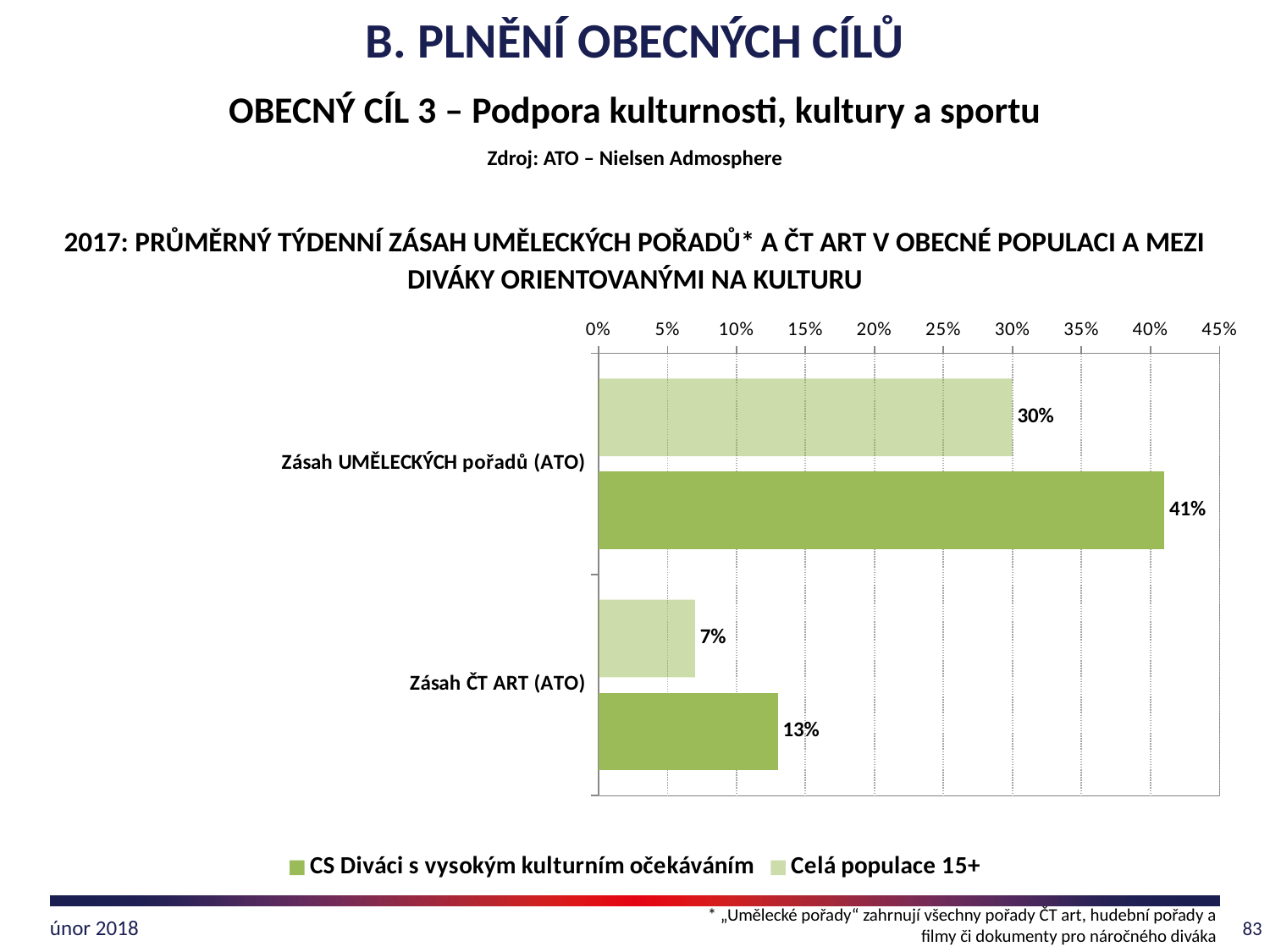
Which bar has the lowest value on the chart? Celá populace 15+, Zásah ČT ART (ATO) What is the value for 'CS Diváci s vysokým kulturním očekáváním' in the 'Zásah UMĚLECKÝCH pořadů (ATO)' category? 41% Which series has the larger value in the 'Zásah ČT ART (ATO)' category? CS Diváci s vysokým kulturním očekáváním What kind of chart is shown on the slide? Bar chart Which bar has the highest value on the chart? CS Diváci s vysokým kulturním očekáváním, Zásah UMĚLECKÝCH pořadů (ATO) What is the difference between the two series in the 'Zásah ČT ART (ATO)' category? 6% What is the value for 'CS Diváci s vysokým kulturním očekáváním' in the 'Zásah ČT ART (ATO)' category? 13% How many series does the legend list? 2 How many categories are shown on the chart? 2 What is the value for 'Celá populace 15+' in the 'Zásah UMĚLECKÝCH pořadů (ATO)' category? 30% What is the value for 'Celá populace 15+' in the 'Zásah ČT ART (ATO)' category? 7% What is the difference between the two series in the 'Zásah UMĚLECKÝCH pořadů (ATO)' category? 11%